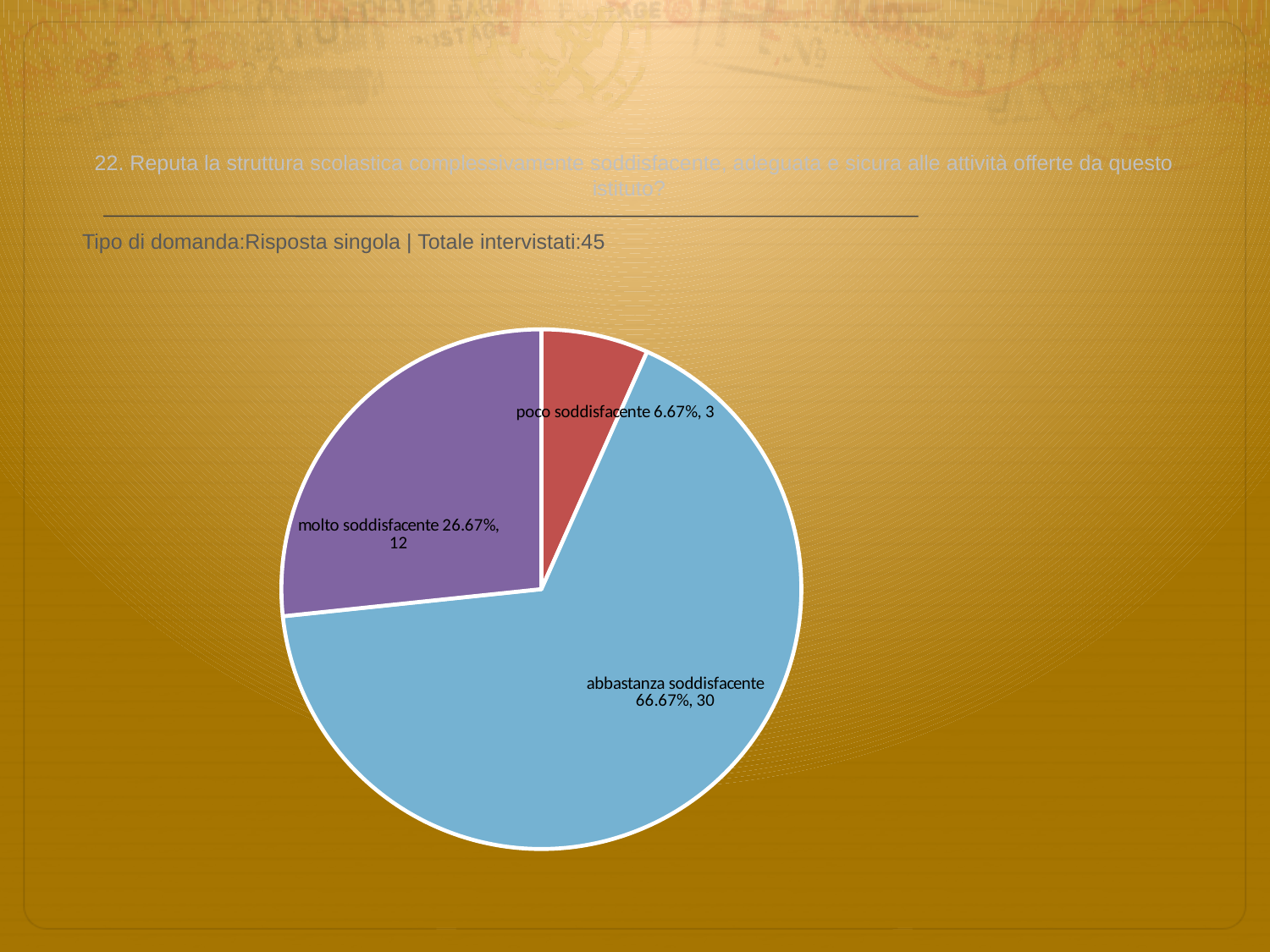
What kind of chart is shown on the slide? pie chart How many respondents answered 'poco soddisfacente'? 3 Which category has the largest slice of the pie? abbastanza soddisfacente How many slices does the pie chart have? 3 What is the difference in respondent count between 'abbastanza soddisfacente' and 'molto soddisfacente'? 18 Which category has the smallest slice of the pie? poco soddisfacente How many respondents answered 'abbastanza soddisfacente'? 30 How many respondents answered 'molto soddisfacente'? 12 What percentage share does the 'abbastanza soddisfacente' slice have? 66.67% Which slice is larger: 'molto soddisfacente' or 'poco soddisfacente'? molto soddisfacente What percentage share does the 'molto soddisfacente' slice have? 26.67% What percentage share does the 'poco soddisfacente' slice have? 6.67%